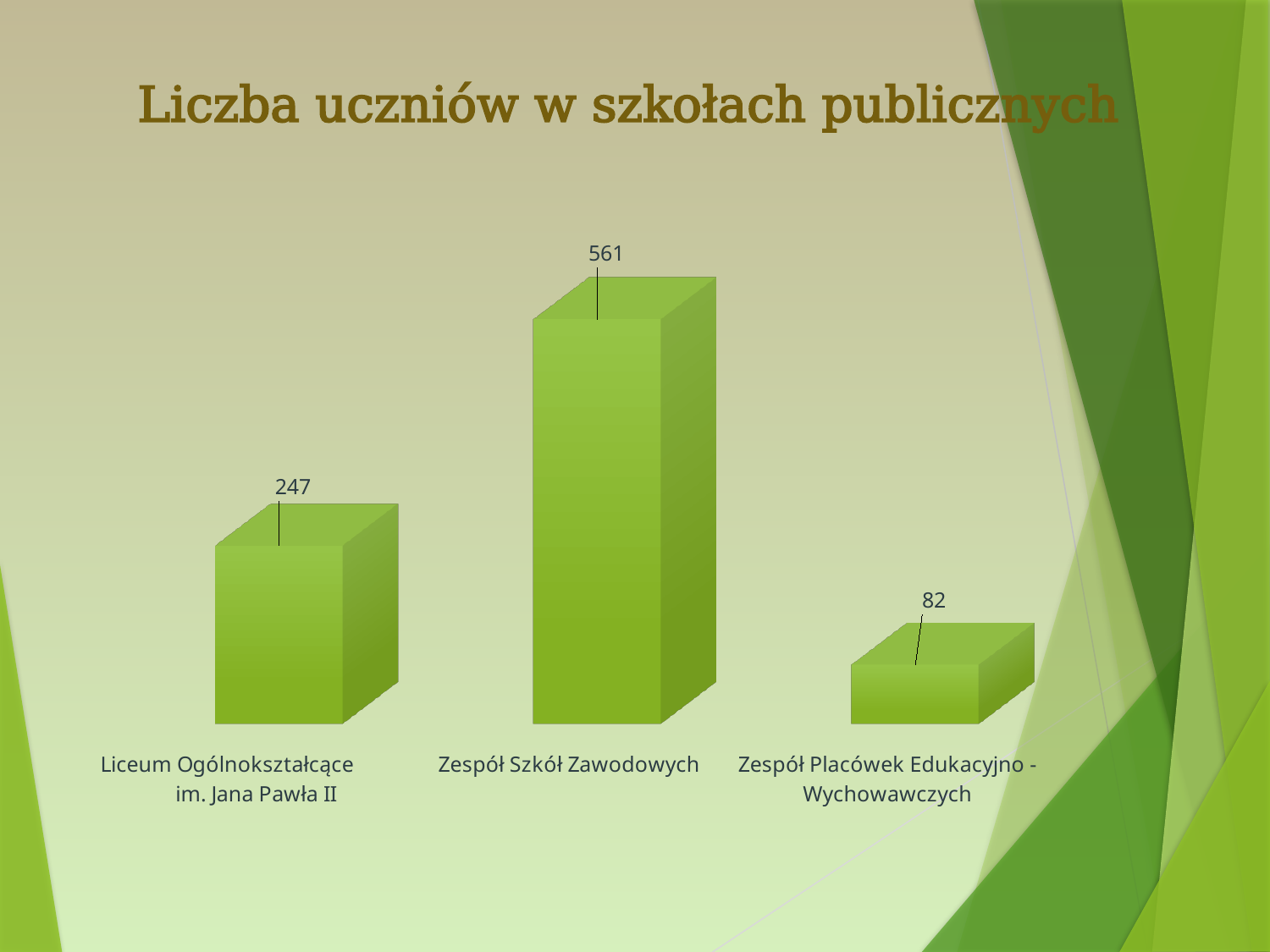
Which has more students, Liceum Ogólnokształcące im. Jana Pawła II or Zespół Placówek Edukacyjno - Wychowawczych? Liceum Ogólnokształcące im. Jana Pawła II What is the number of students for Liceum Ogólnokształcące im. Jana Pawła II? 247 What is the difference in the number of students between Zespół Szkół Zawodowych and Liceum Ogólnokształcące im. Jana Pawła II? 314 Which school has the highest number of students? Zespół Szkół Zawodowych What is the number of students for Zespół Placówek Edukacyjno - Wychowawczych? 82 What is the difference in the number of students between Liceum Ogólnokształcące im. Jana Pawła II and Zespół Placówek Edukacyjno - Wychowawczych? 165 What is the number of students for Zespół Szkół Zawodowych? 561 What kind of chart is shown on the slide? Bar chart What is the title of the slide? Liczba uczniów w szkołach publicznych How many schools are shown in the chart? 3 Which school has the lowest number of students? Zespół Placówek Edukacyjno - Wychowawczych What is the total number of students across all three schools shown? 890